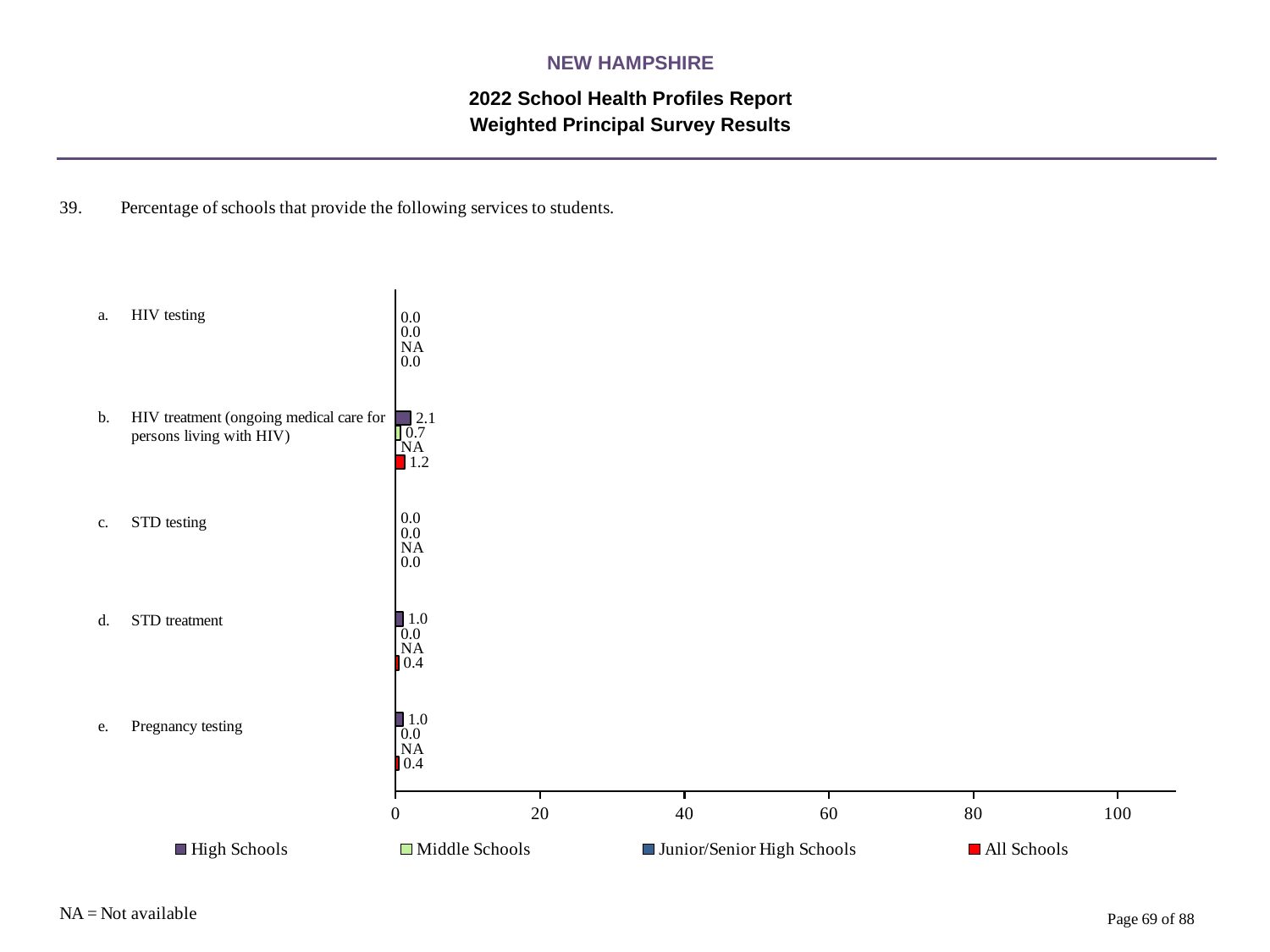
How many services are listed on the chart? 5 Which is larger for STD treatment: the High Schools value or the All Schools value? High Schools What is the value for All Schools for HIV treatment (ongoing medical care for persons living with HIV)? 1.2 What is shown for Junior/Senior High Schools for STD testing? NA What is the value for All Schools for Pregnancy testing? 0.4 Which service has the highest value for High Schools? HIV treatment (ongoing medical care for persons living with HIV) What is the difference between the High Schools and Middle Schools values for HIV treatment (ongoing medical care for persons living with HIV)? 1.4 What kind of chart is shown on the slide? Bar chart How many series does the legend list? 4 What is the value for Middle Schools for HIV treatment (ongoing medical care for persons living with HIV)? 0.7 What is the value for High Schools for STD treatment? 1.0 What is the value for High Schools for HIV treatment (ongoing medical care for persons living with HIV)? 2.1